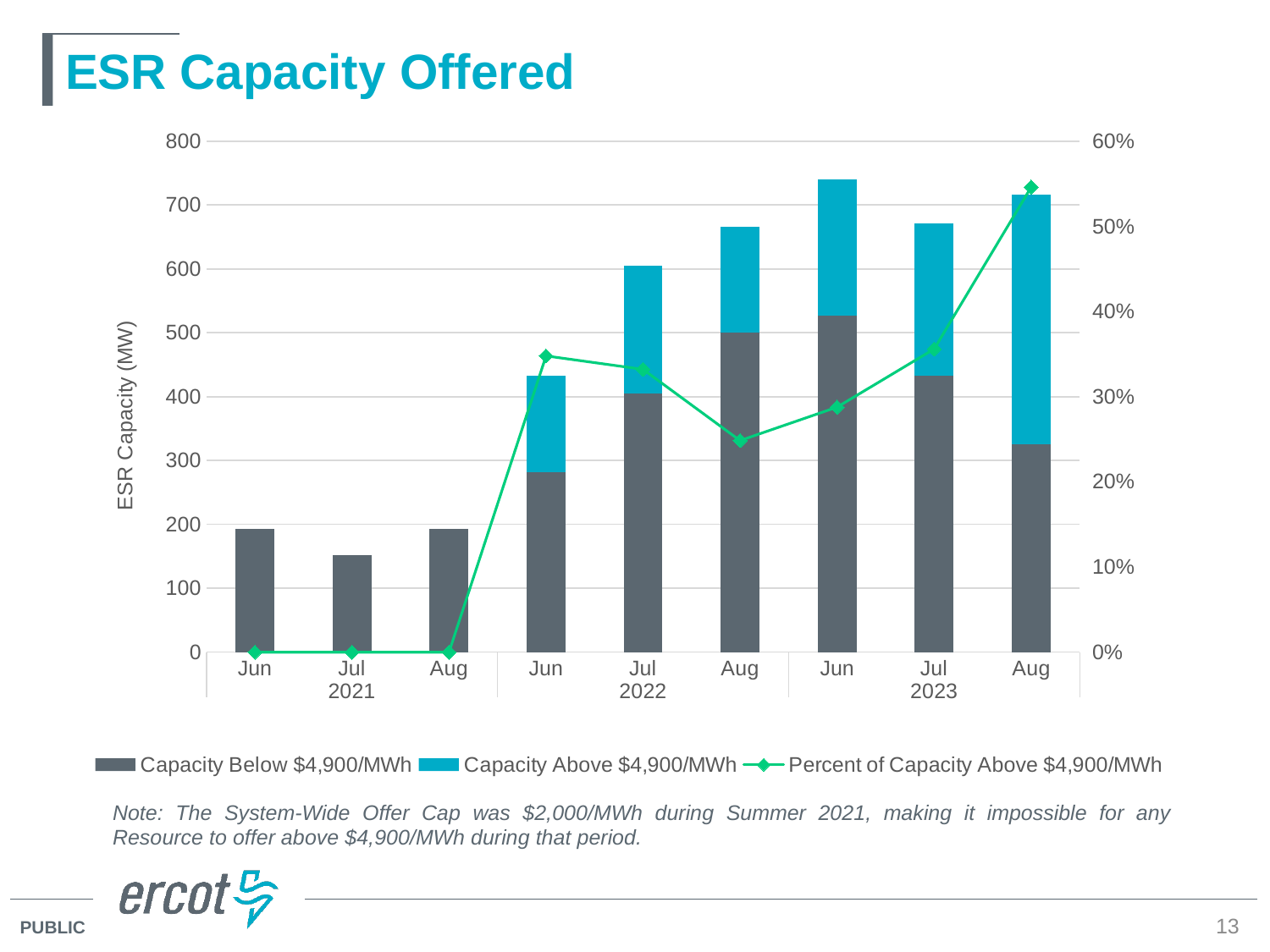
Does the Percent of Capacity Above $4,900/MWh rise or fall from Jun 2023 to Aug 2023? rise Which has the larger total ESR capacity, Jun 2023 or Jul 2023? Jun 2023 What kind of chart is shown on the slide? A stacked bar chart with a line What is the label of the left vertical axis? ESR Capacity (MW) Is the Percent of Capacity Above $4,900/MWh for Aug 2023 greater or less than 50%? greater Which month has the lowest total ESR capacity offered? Jul 2021 Which month has the largest Capacity Above $4,900/MWh segment? Aug 2023 Which month has the highest Percent of Capacity Above $4,900/MWh? Aug 2023 How many months (bars) are plotted on the x axis? 9 Is the total ESR capacity for Jun 2023 greater or less than 700 MW? greater How many series does the legend list? 3 Is the total ESR capacity for Jul 2021 greater or less than 200 MW? less